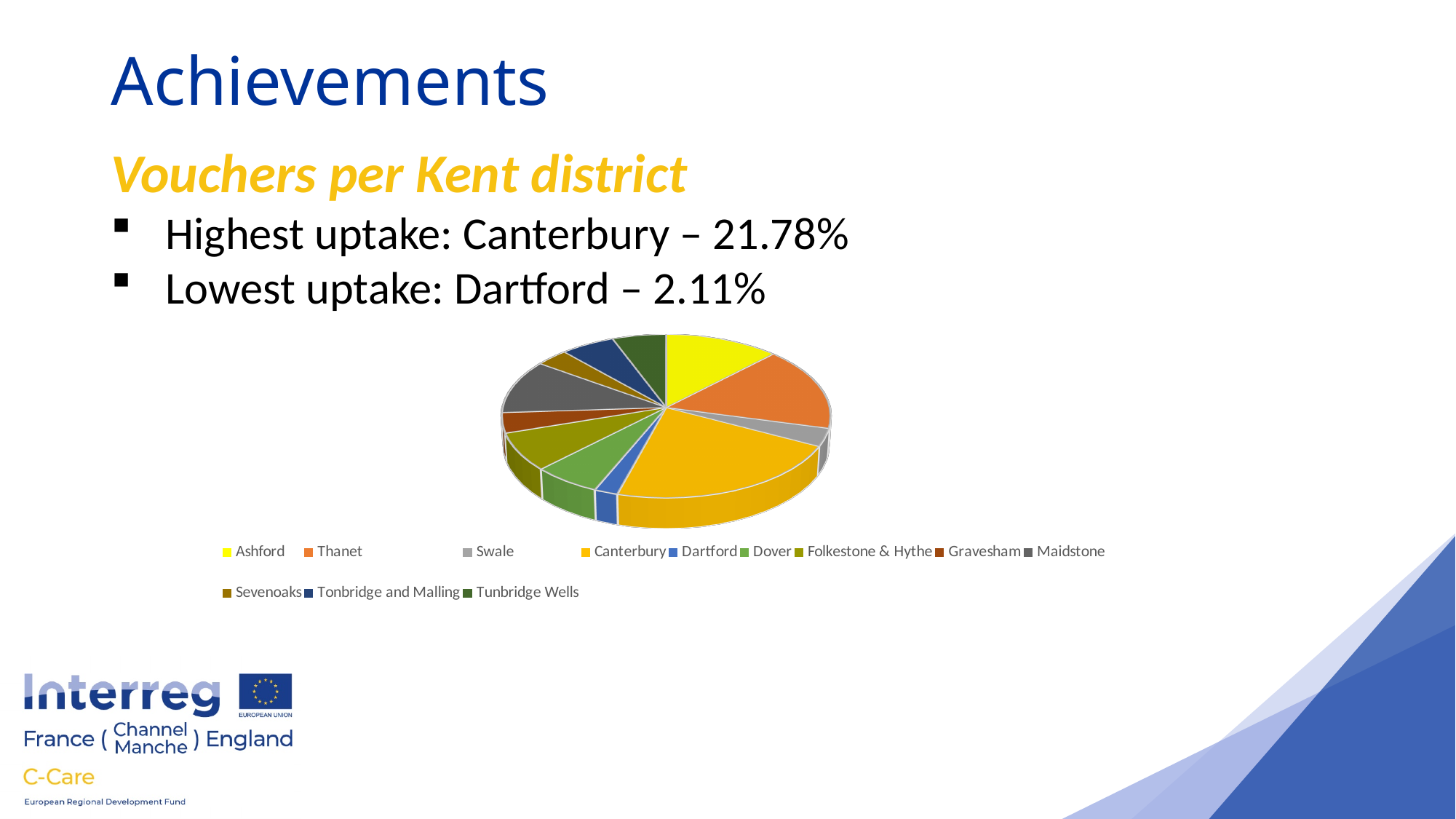
Which slice is larger in the pie chart, Thanet or Swale? Thanet What is the heading shown above the pie chart? Vouchers per Kent district Which slice is larger in the pie chart, Maidstone or Gravesham? Maidstone What share of vouchers does Canterbury have, according to the slide? 21.78% What kind of chart is shown on the slide? pie chart Which district has the largest slice of the pie chart? Canterbury Which district has the smallest slice of the pie chart? Dartford What is the difference between Canterbury's uptake and Dartford's uptake? 19.67% Which slice is larger in the pie chart, Canterbury or Ashford? Canterbury How many districts (categories) does the pie chart's legend list? 12 What share of vouchers does Dartford have, according to the slide? 2.11% What colour is the Thanet slice in the pie chart? orange